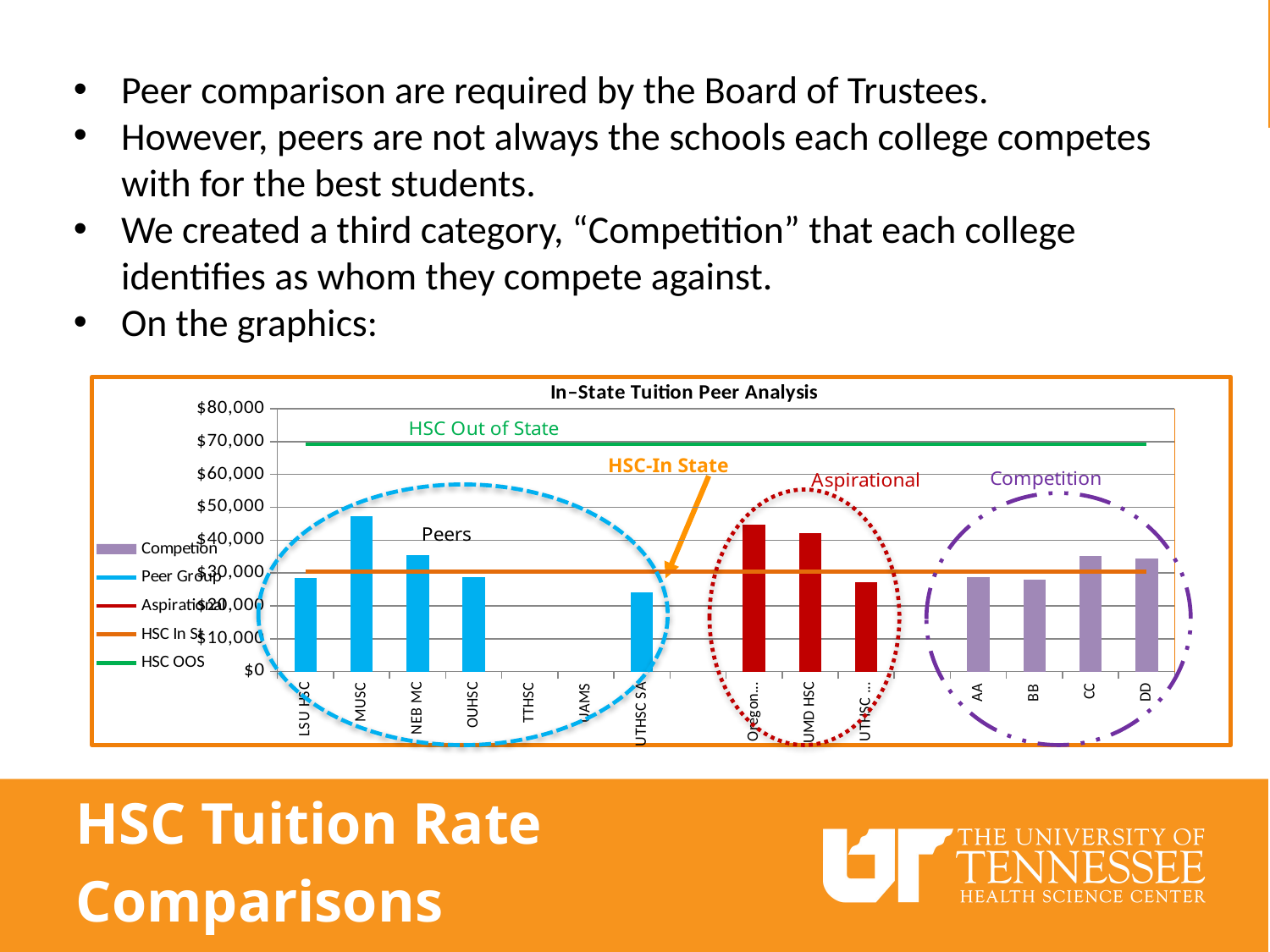
Which has the larger value, MUSC or LSU HSC? MUSC Is the value for LSU HSC greater or less than $30,000? less Is the value for CC greater or less than $30,000? greater Is the value for UTHSC SA greater or less than $30,000? less How many entries does the chart legend list? 5 Which has the larger value, NEB MC or OUHSC? NEB MC How many categories are labelled along the x axis of the chart? 14 What kind of chart is shown on the slide? combination bar and line chart Which group of bars is circled with the purple dash-dot line? Competition What is the title of the chart? In-State Tuition Peer Analysis